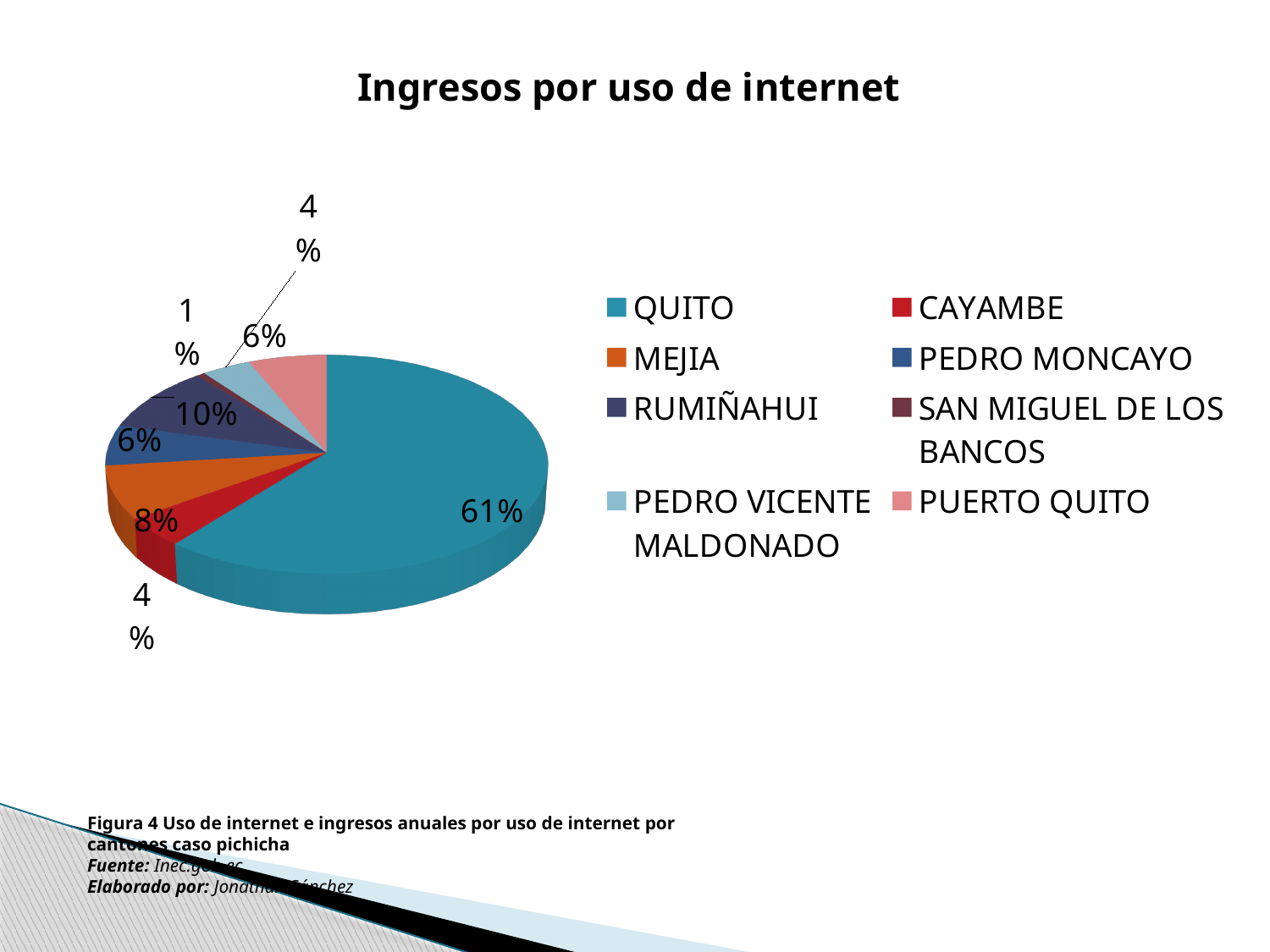
Which category has the smallest slice of the pie? SAN MIGUEL DE LOS BANCOS What share of the pie does MEJIA have? 8% What is the difference in percentage points between the shares of QUITO and RUMIÑAHUI? 51 Which has a larger share, MEJIA or PEDRO MONCAYO? MEJIA What share of the pie does QUITO have? 61% How many categories does the legend of the pie chart list? 8 What share of the pie does RUMIÑAHUI have? 10% What is the title of the chart? Ingresos por uso de internet What type of chart is shown on the slide? pie chart Which category has the largest slice of the pie? QUITO Which colour represents QUITO in the pie chart? teal